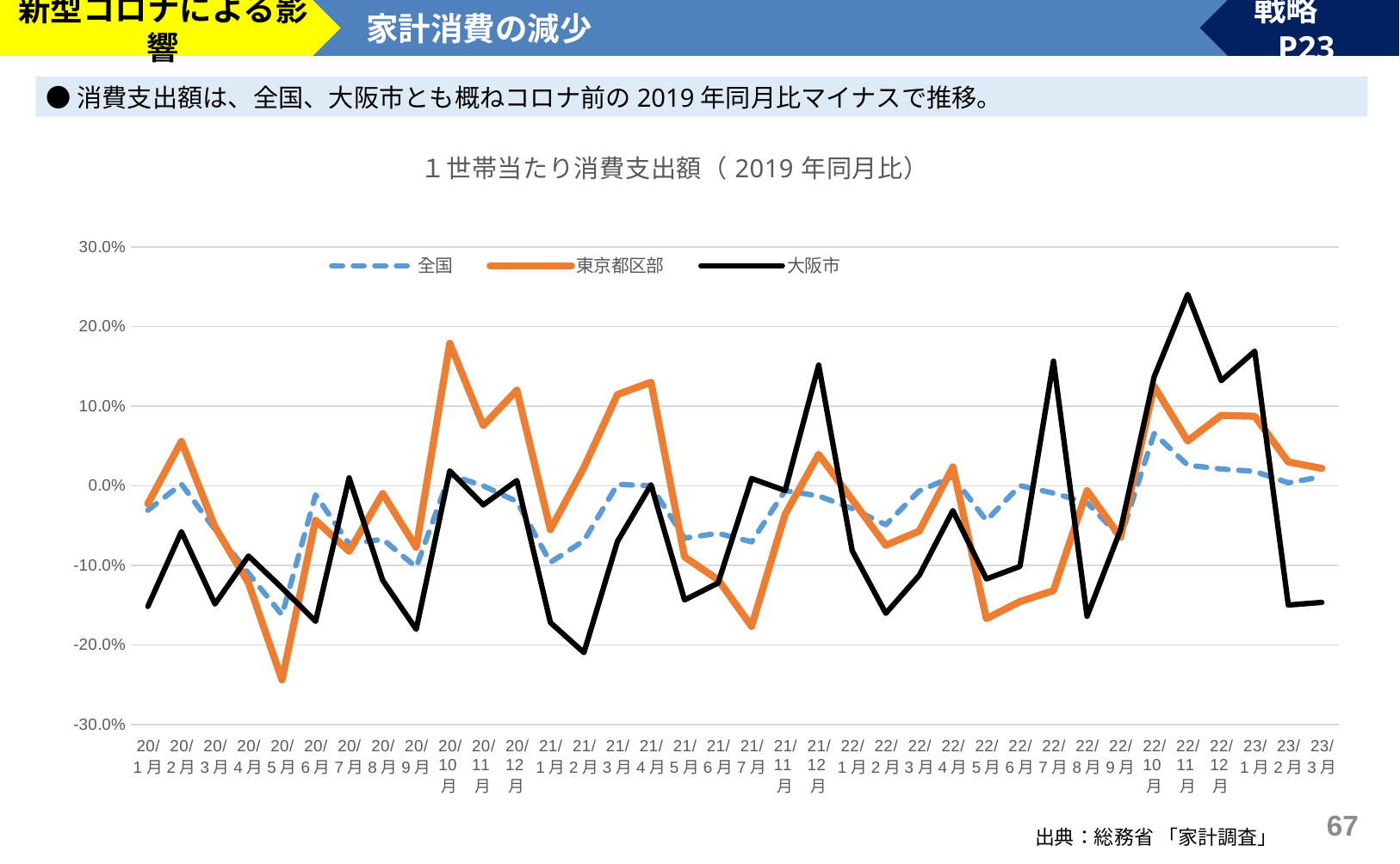
Is the value for 全国 in 22/10月 greater or less than 0.0%? greater Is the value for 東京都区部 in 20/5月 greater or less than -20.0%? less In 20/10月, which is larger: the value for 東京都区部 or the value for 大阪市? 東京都区部 What is the title of the chart? １世帯当たり消費支出額（2019年同月比） Is the value for 大阪市 in 23/2月 greater or less than -10.0%? less Which series reaches the lowest value anywhere on the chart? 東京都区部 What kind of chart is shown on the slide? line chart How many series does the legend list? 3 Which series is drawn as a dashed line? 全国 Which series reaches the highest value anywhere on the chart? 大阪市